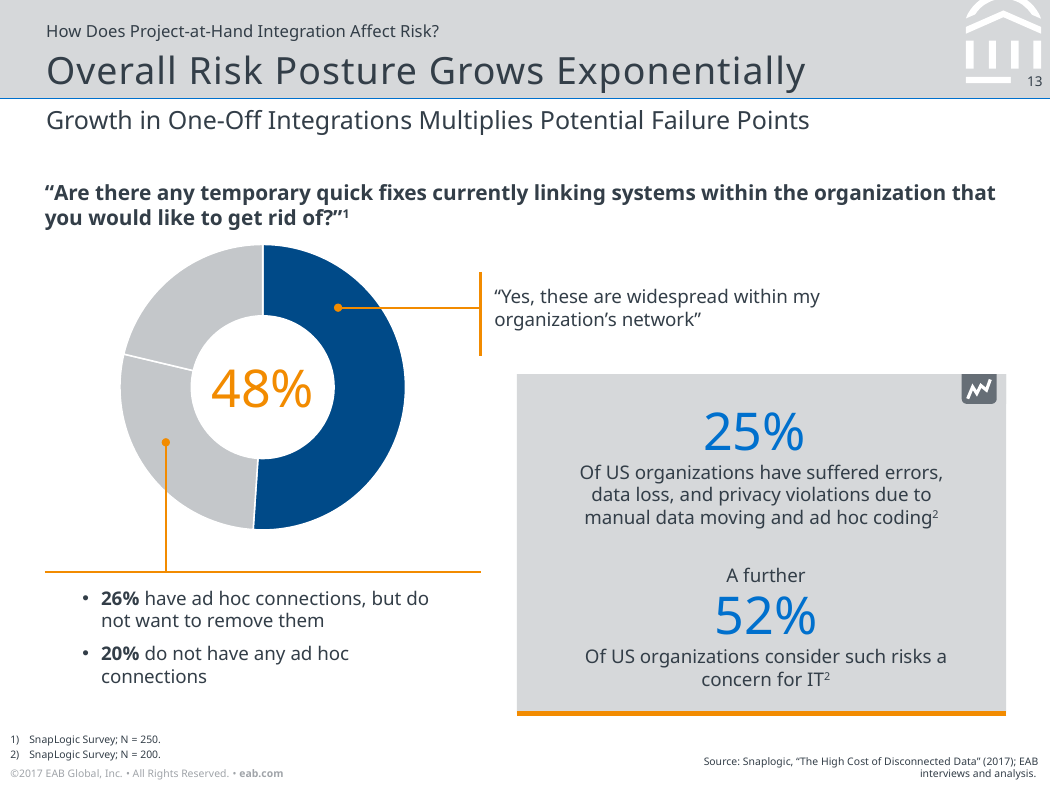
Which response has the largest share of the donut chart? "Yes, these are widespread within my organization's network" What share of respondents have ad hoc connections but do not want to remove them? 26% What colour is the slice representing the 48% "Yes, these are widespread" response? Dark blue What share of respondents said "Yes, these are widespread within my organization's network"? 48% What survey question is the donut chart based on? "Are there any temporary quick fixes currently linking systems within the organization that you would like to get rid of?" How many slices does the donut chart have? 3 Which response has the smallest share of the donut chart? Do not have any ad hoc connections Which is larger: the share that have ad hoc connections but do not want to remove them, or the share that do not have any ad hoc connections? Have ad hoc connections but do not want to remove them What is the difference in percentage points between the "Yes, these are widespread" share and the share that do not have any ad hoc connections? 28 percentage points What share of respondents do not have any ad hoc connections? 20% What is the difference in percentage points between the share that have ad hoc connections but do not want to remove them and the share that do not have any ad hoc connections? 6 percentage points What kind of chart is shown on the slide? Donut (pie) chart